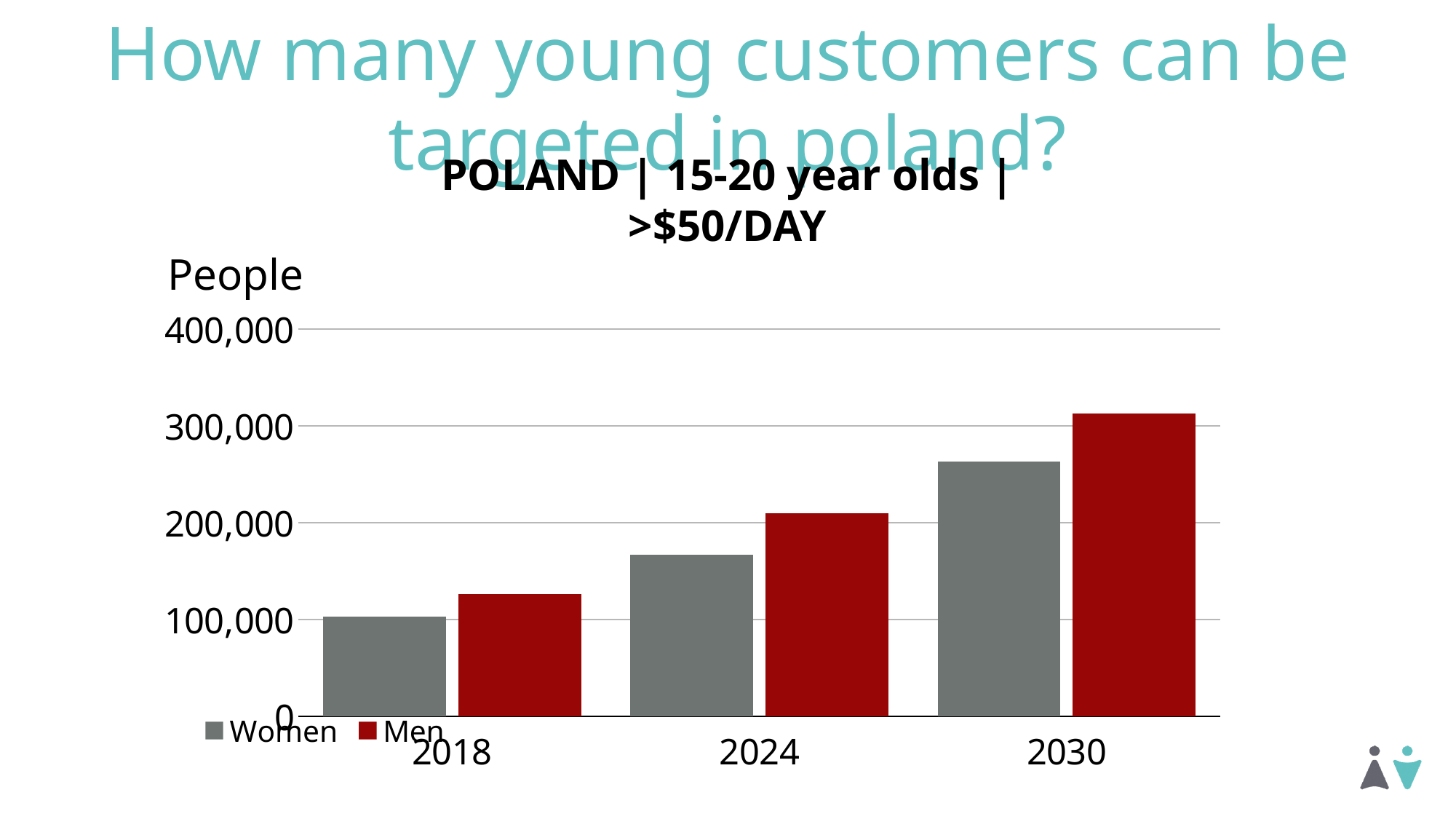
In 2030, which is larger, the value for Women or the value for Men? Men How many years are shown on the x axis? 3 Which series and year has the lowest bar? Women in 2018 Do the values for Women rise or fall from 2018 to 2030? rise In 2024, which is larger, the value for Women or the value for Men? Men Which series and year has the highest bar? Men in 2030 How many series does the legend list? 2 Is the value for Men in 2030 greater or less than 300,000? greater What colour are the bars for Men? red Is the value for Women in 2024 greater or less than 200,000? less Is the value for Men in 2018 greater or less than 200,000? less What kind of chart is shown on the slide? bar chart